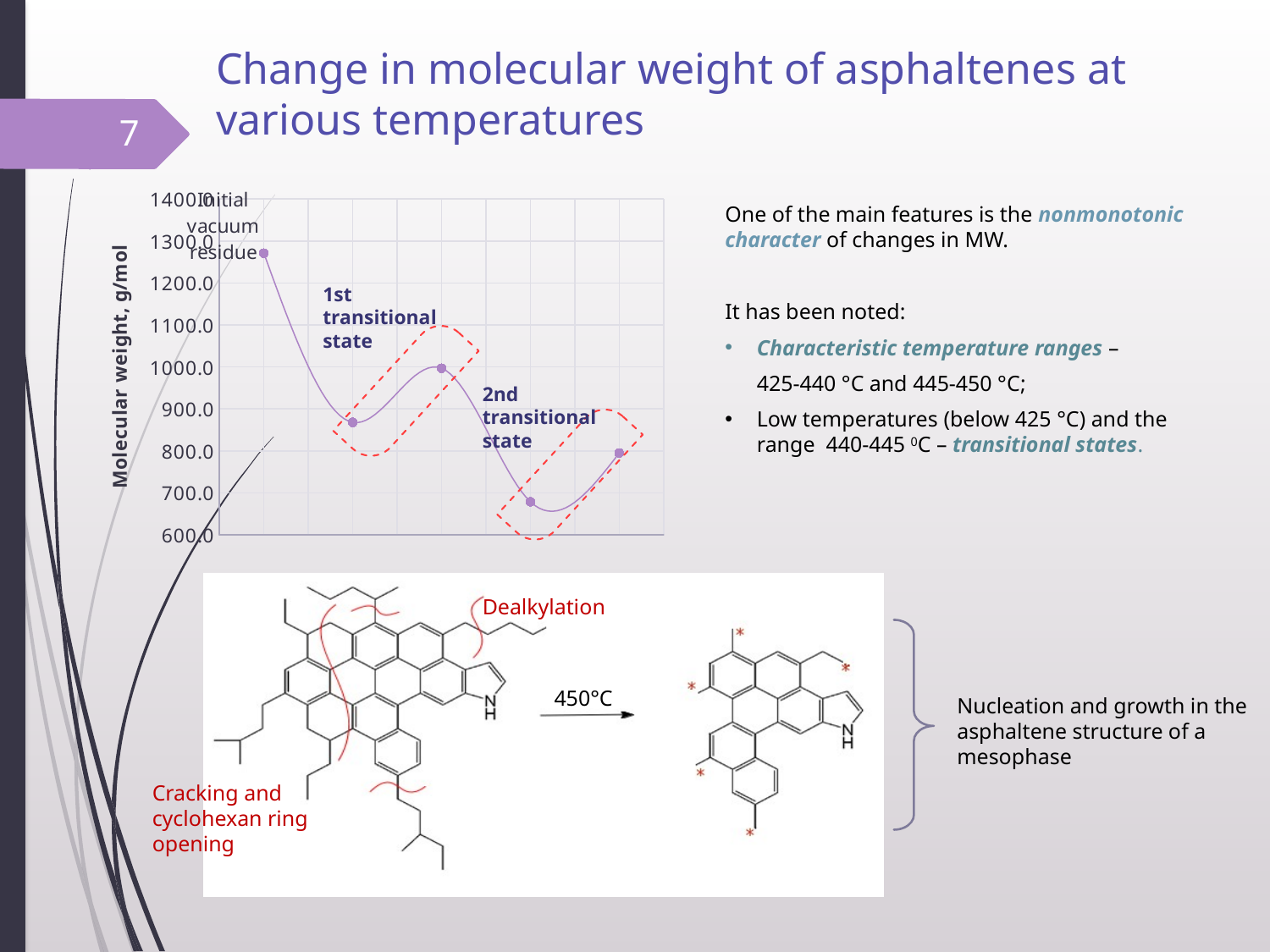
Is the value for the fourth point on the chart greater or less than 800.0? less Is the value for the third point on the chart greater or less than 900.0? greater What is the title of the vertical axis of the chart? Molecular weight, g/mol Is the value for the Initial vacuum residue point greater or less than 1200.0? greater Which data point on the chart has the lowest molecular weight? the fourth point Which data point on the chart has the highest molecular weight? Initial vacuum residue (the first point) Which is larger on the chart, the value of the second point or the value of the third point? the third point What label is given to the dashed region around the fourth and fifth points on the chart? 2nd transitional state How many data points are plotted on the line chart? 5 What kind of chart is shown on the slide? line chart